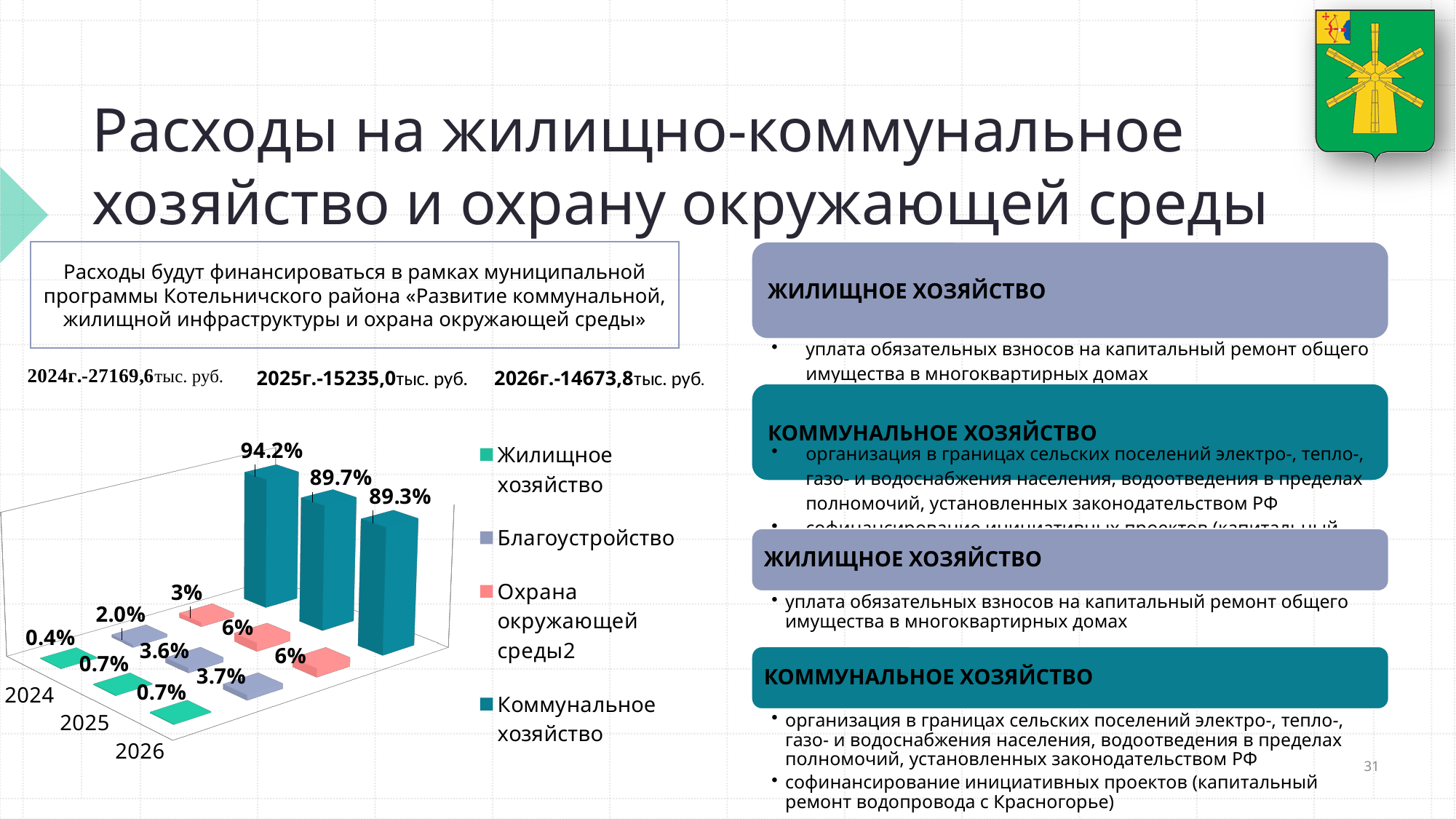
Which series has the highest value in 2025? Коммунальное хозяйство What is the difference between the Коммунальное хозяйство values for 2024 and 2025? 4.5% What is the value for Охрана окружающей среды2 in 2026? 6% Which series has the lowest value in 2026? Жилищное хозяйство Does the value for Коммунальное хозяйство rise or fall from 2024 to 2026? fall What is the value for Благоустройство in 2025? 3.6% How many years are shown on the chart's axis? 3 What is the value for Жилищное хозяйство in 2024? 0.4% What is the value for Коммунальное хозяйство in 2026? 89.3% How many series does the chart legend list? 4 What is the value for Коммунальное хозяйство in 2024? 94.2% What kind of chart is shown on the slide? bar chart